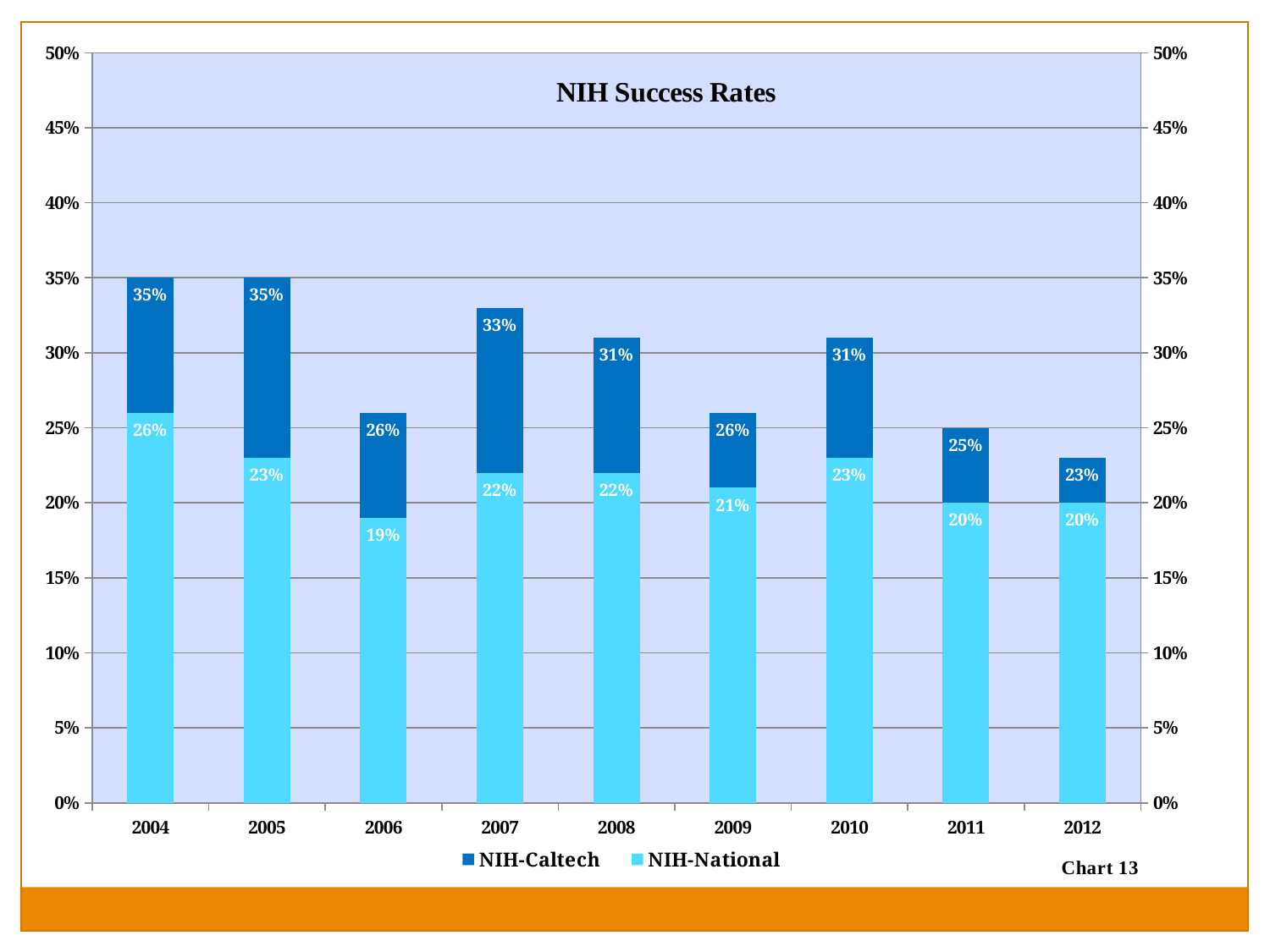
What is the NIH-Caltech success rate for 2004? 35% Which year has the lowest NIH-National success rate? 2006 What is the NIH-National success rate for 2010? 23% How many series does the legend list? 2 What is the NIH-National success rate for 2006? 19% What kind of chart is this? Bar chart What is the difference between the NIH-Caltech and NIH-National success rates in 2007? 11% What is the NIH-Caltech success rate for 2012? 23% Which year has the lowest NIH-Caltech success rate? 2012 What is the title of the chart? NIH Success Rates How many years are shown on the x axis? 9 Which is larger in 2009, the NIH-Caltech rate or the NIH-National rate? NIH-Caltech